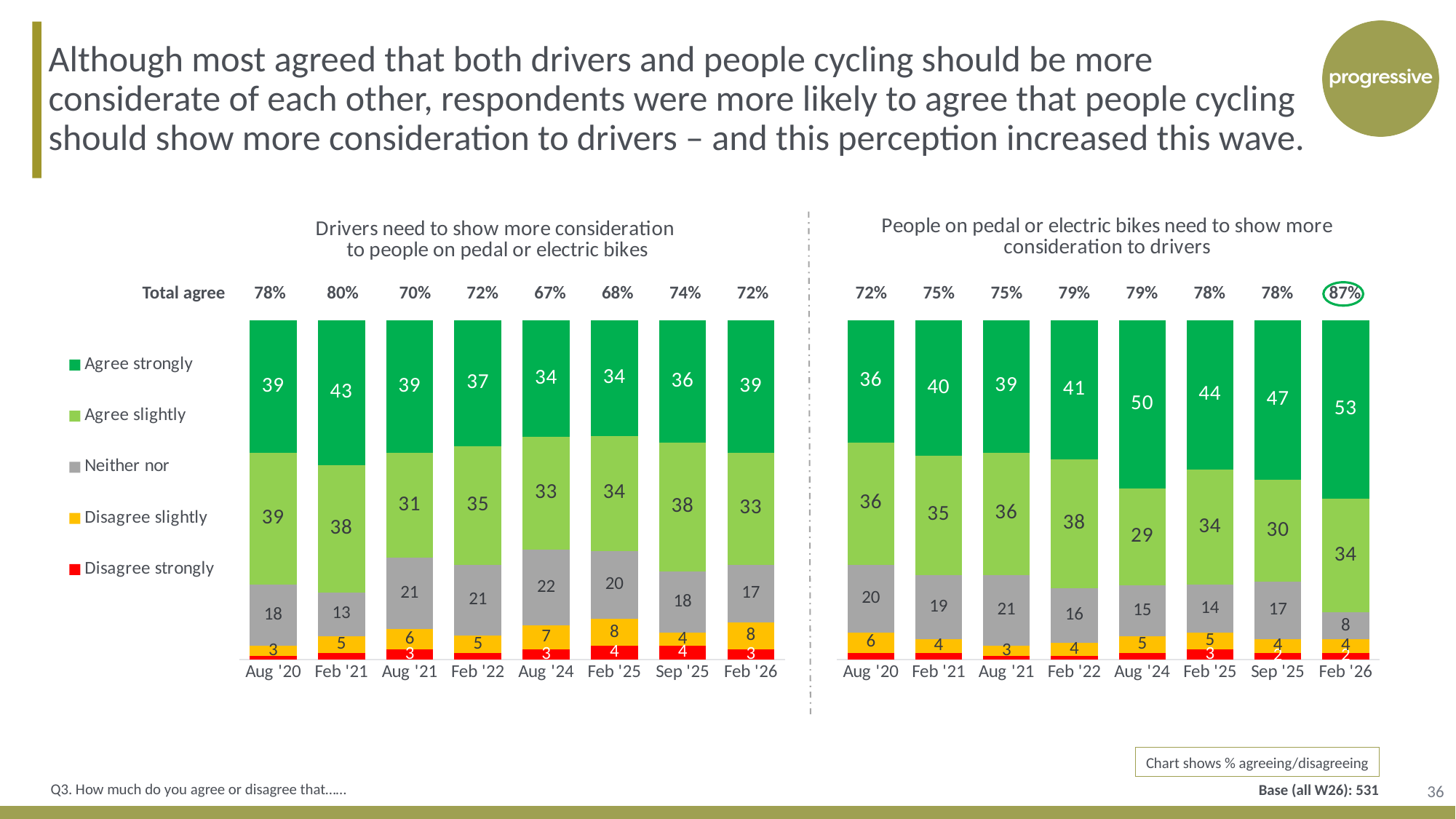
In the right chart (People on pedal or electric bikes need to show more consideration to drivers), which wave has the lowest Agree strongly value? Aug '20 In the left chart (Drivers need to show more consideration to people on pedal or electric bikes), which wave has the lowest Total agree figure? Aug '24 In the left chart (Drivers need to show more consideration to people on pedal or electric bikes), what is the Agree strongly value for Feb '21? 43 In the right chart (People on pedal or electric bikes need to show more consideration to drivers), what is the Agree strongly value for Feb '26? 53 What kind of chart is the left chart (Drivers need to show more consideration to people on pedal or electric bikes)? Stacked bar chart In the left chart (Drivers need to show more consideration to people on pedal or electric bikes), which wave has the highest Total agree figure? Feb '21 In the left chart (Drivers need to show more consideration to people on pedal or electric bikes), is the Neither nor value larger for Aug '21 or Feb '21? Aug '21 How many waves (categories) are shown in the right chart (People on pedal or electric bikes need to show more consideration to drivers)? 8 In the right chart (People on pedal or electric bikes need to show more consideration to drivers), what is the difference between the Agree strongly values for Feb '26 and Sep '25? 6 How many series does the legend list? 5 In the right chart (People on pedal or electric bikes need to show more consideration to drivers), what is the Total agree figure for Feb '26? 87% In the right chart (People on pedal or electric bikes need to show more consideration to drivers), what is the Neither nor value for Feb '26? 8